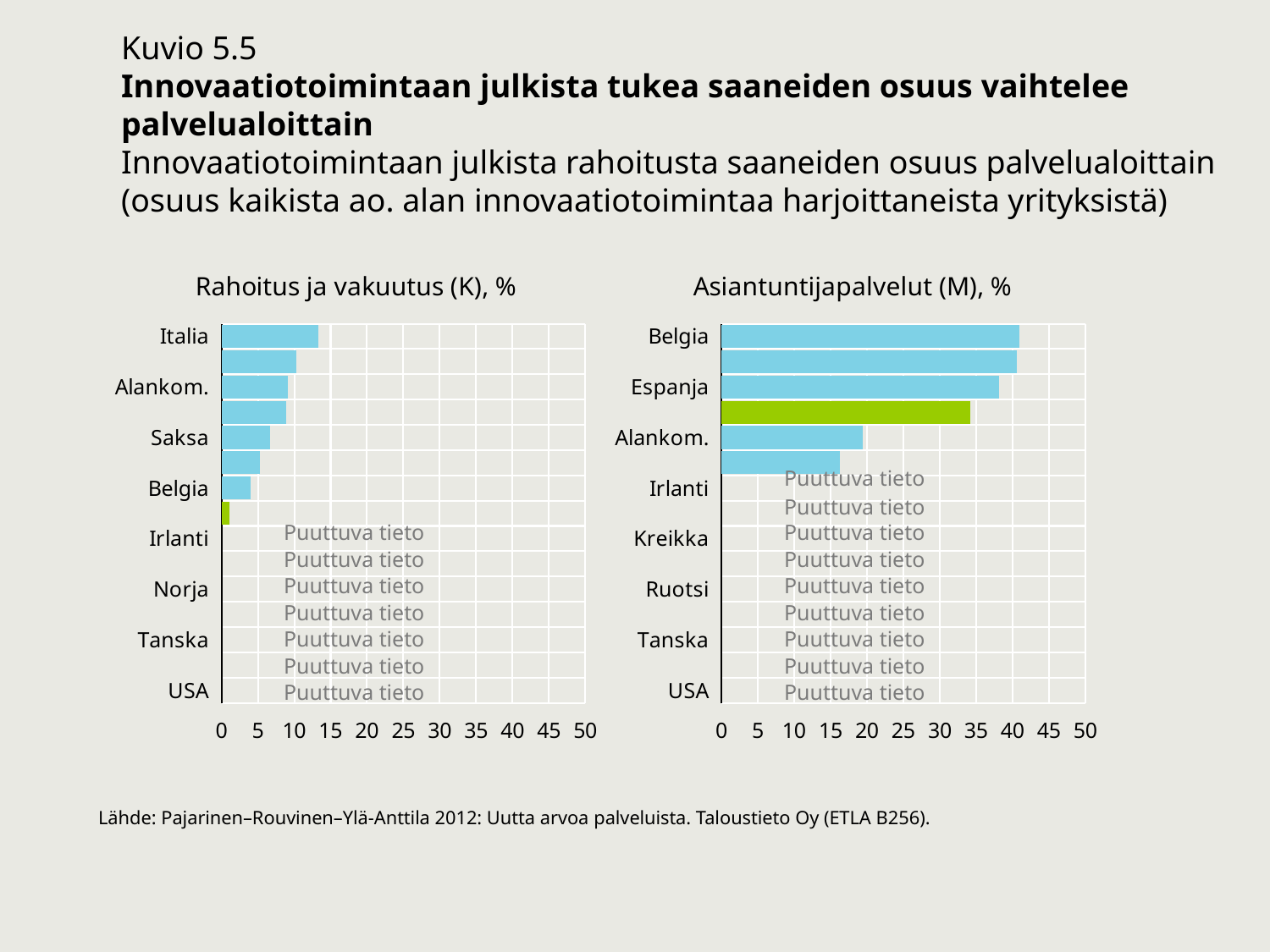
In the left chart "Rahoitus ja vakuutus (K), %", which labelled country has the highest value? Italia What text is shown in place of bars for countries with no data in both charts? Puuttuva tieto What is the highest value shown on the x axis of the right chart "Asiantuntijapalvelut (M), %"? 50 In the left chart "Rahoitus ja vakuutus (K), %", is the value for Saksa greater or less than 10? less What kind of chart is the left chart titled "Rahoitus ja vakuutus (K), %"? bar chart In the right chart "Asiantuntijapalvelut (M), %", is the value for Belgia greater or less than 35? greater In the right chart "Asiantuntijapalvelut (M), %", which labelled country has the highest value? Belgia Is the value for Belgia larger in the left chart "Rahoitus ja vakuutus (K), %" or in the right chart "Asiantuntijapalvelut (M), %"? Asiantuntijapalvelut (M), % In the left chart "Rahoitus ja vakuutus (K), %", which is larger, the value for Italia or the value for Belgia? Italia In the right chart "Asiantuntijapalvelut (M), %", which is larger, the value for Espanja or the value for Alankom.? Espanja In the left chart "Rahoitus ja vakuutus (K), %", is the value for Italia greater or less than 10? greater